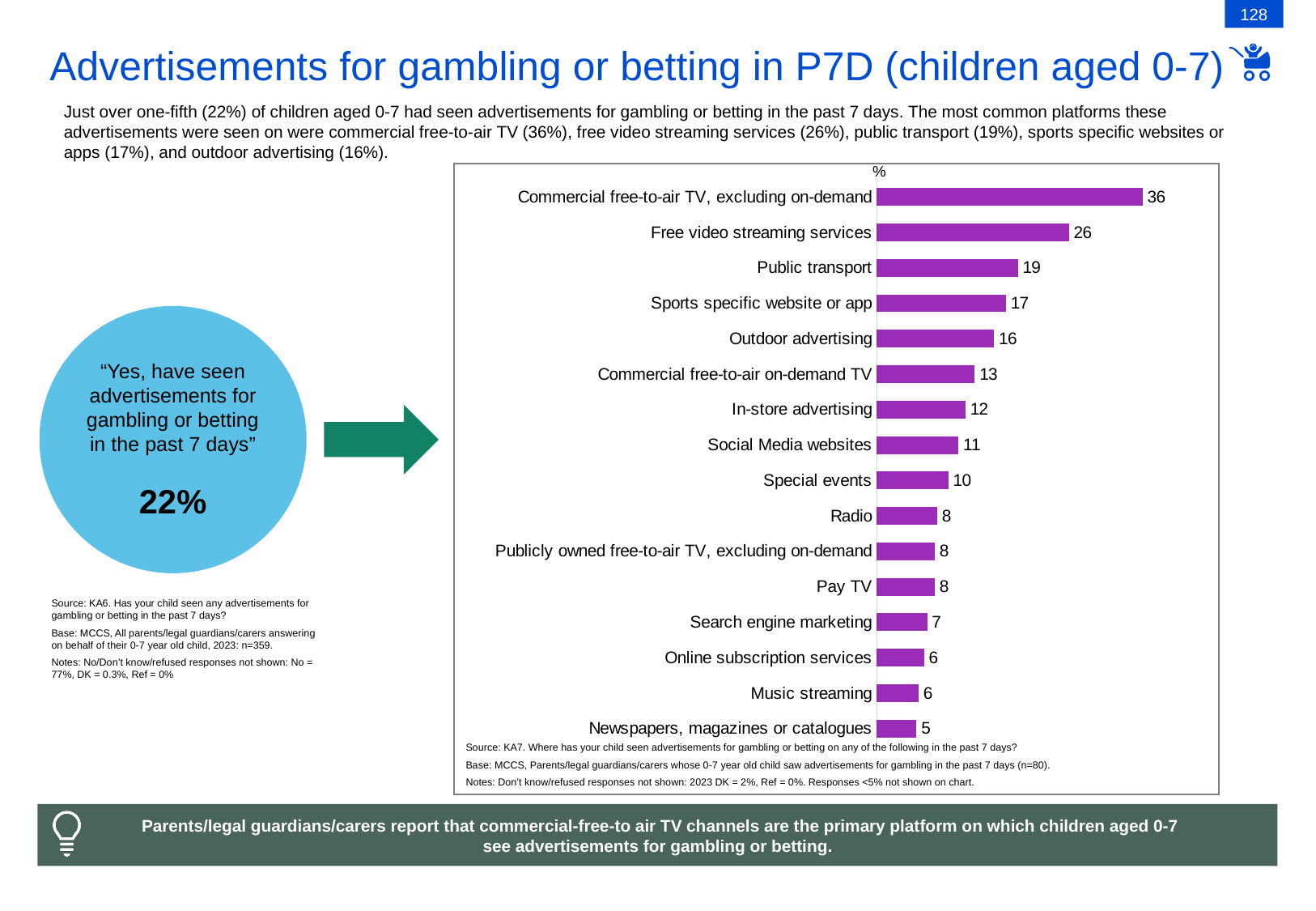
What is the difference between the values for Free video streaming services and Outdoor advertising? 10 Which is larger, the value for Sports specific website or app or the value for In-store advertising? Sports specific website or app How many categories are shown in the chart? 16 What kind of chart is shown on the slide? Bar chart What is the value for Public transport? 19 Which category has the lowest value? Newspapers, magazines or catalogues What colour are the bars in the chart? Purple What is the difference between the values for Special events and Search engine marketing? 3 What is the value for Social Media websites? 11 What is the value for Commercial free-to-air TV, excluding on-demand? 36 Which category has the highest value? Commercial free-to-air TV, excluding on-demand What is the value for Newspapers, magazines or catalogues? 5